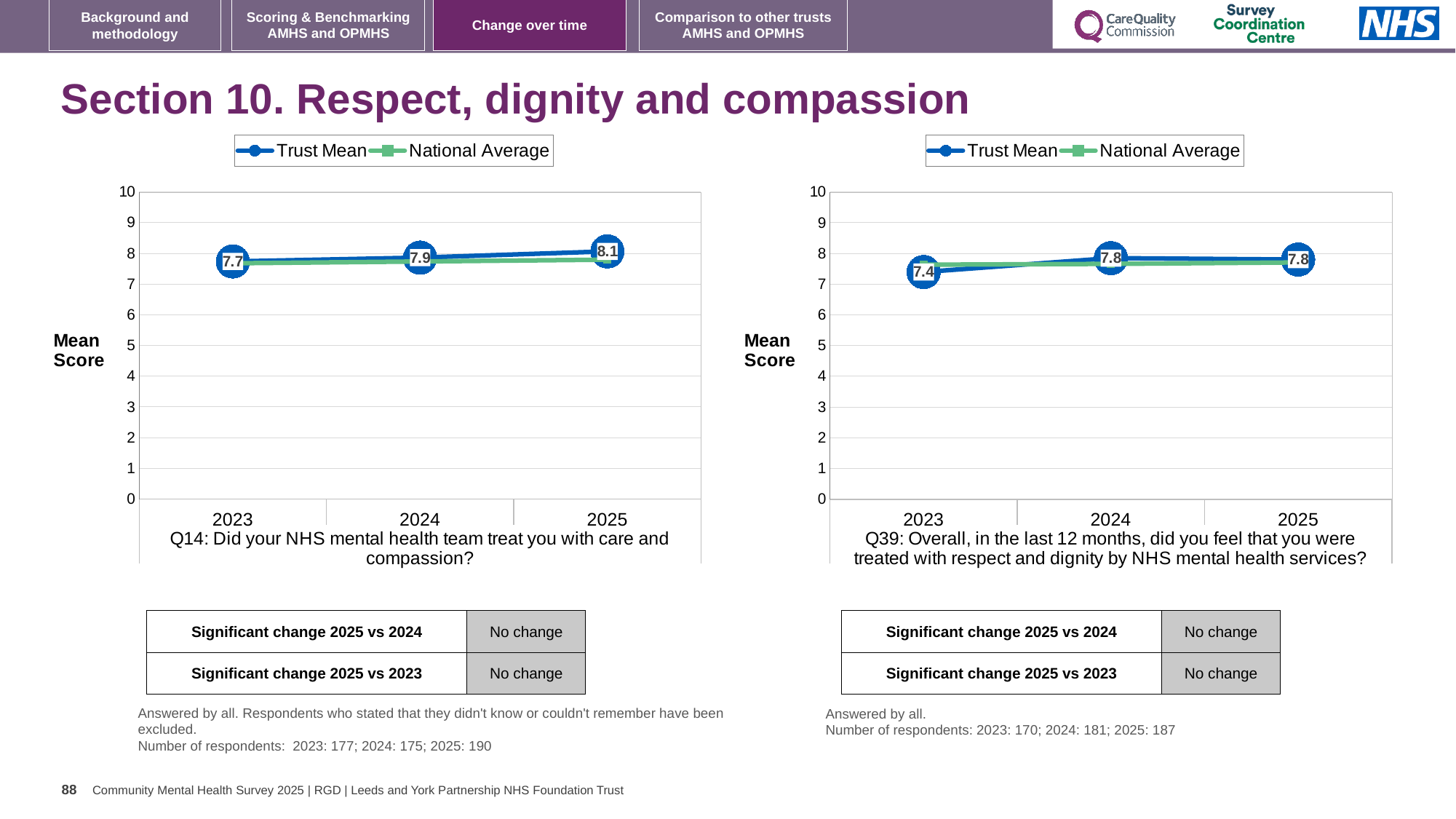
In the right chart (Q39), what is the difference between the Trust Mean for 2024 and the Trust Mean for 2023? 0.4 In the left chart (Q14), does the Trust Mean rise or fall from 2023 to 2025? Rise In the right chart (Q39), which year has the lowest Trust Mean? 2023 In the left chart (Q14), which year has the highest Trust Mean? 2025 How many series does the legend of the right chart (Q39) list? 2 In the right chart (Q39: Overall, in the last 12 months, did you feel that you were treated with respect and dignity by NHS mental health services?), what is the Trust Mean for 2023? 7.4 In the left chart (Q14: Did your NHS mental health team treat you with care and compassion?), what is the Trust Mean for 2025? 8.1 In the left chart (Q14), what is the Trust Mean for 2023? 7.7 Which is larger: the Trust Mean for 2025 in the left chart (Q14) or the Trust Mean for 2025 in the right chart (Q39)? Left chart (Q14), 8.1 What type of chart is the left chart (Q14)? Line chart In the right chart (Q39), what is the Trust Mean for 2024? 7.8 In the left chart (Q14), what is the difference between the Trust Mean for 2025 and the Trust Mean for 2023? 0.4